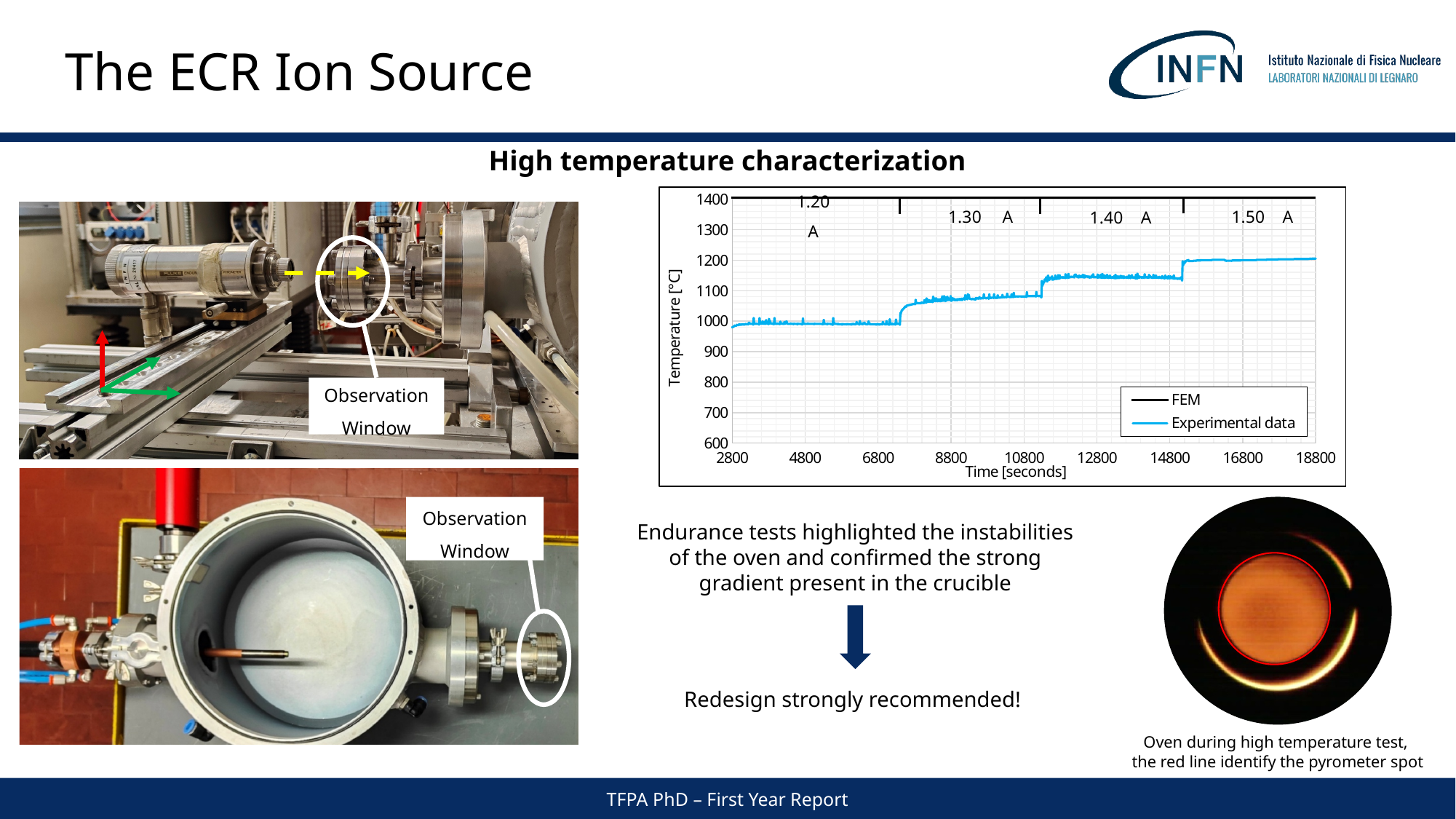
Is the Experimental data temperature at 12800 seconds greater or less than 1200? less What are the two series named in the legend of the temperature chart? FEM and Experimental data What is the label of the y axis of the temperature chart? Temperature [°C] Is the Experimental data temperature at 8800 seconds greater or less than 1000? greater Is the Experimental data temperature at 4800 seconds greater or less than 1100? less How many series does the legend of the temperature chart list? 2 What kind of chart is shown under 'High temperature characterization'? line chart Which is larger in the temperature chart: the Experimental data value at 4800 seconds or at 16800 seconds? 16800 seconds Does the Experimental data series rise or fall as time increases along the x axis? rise